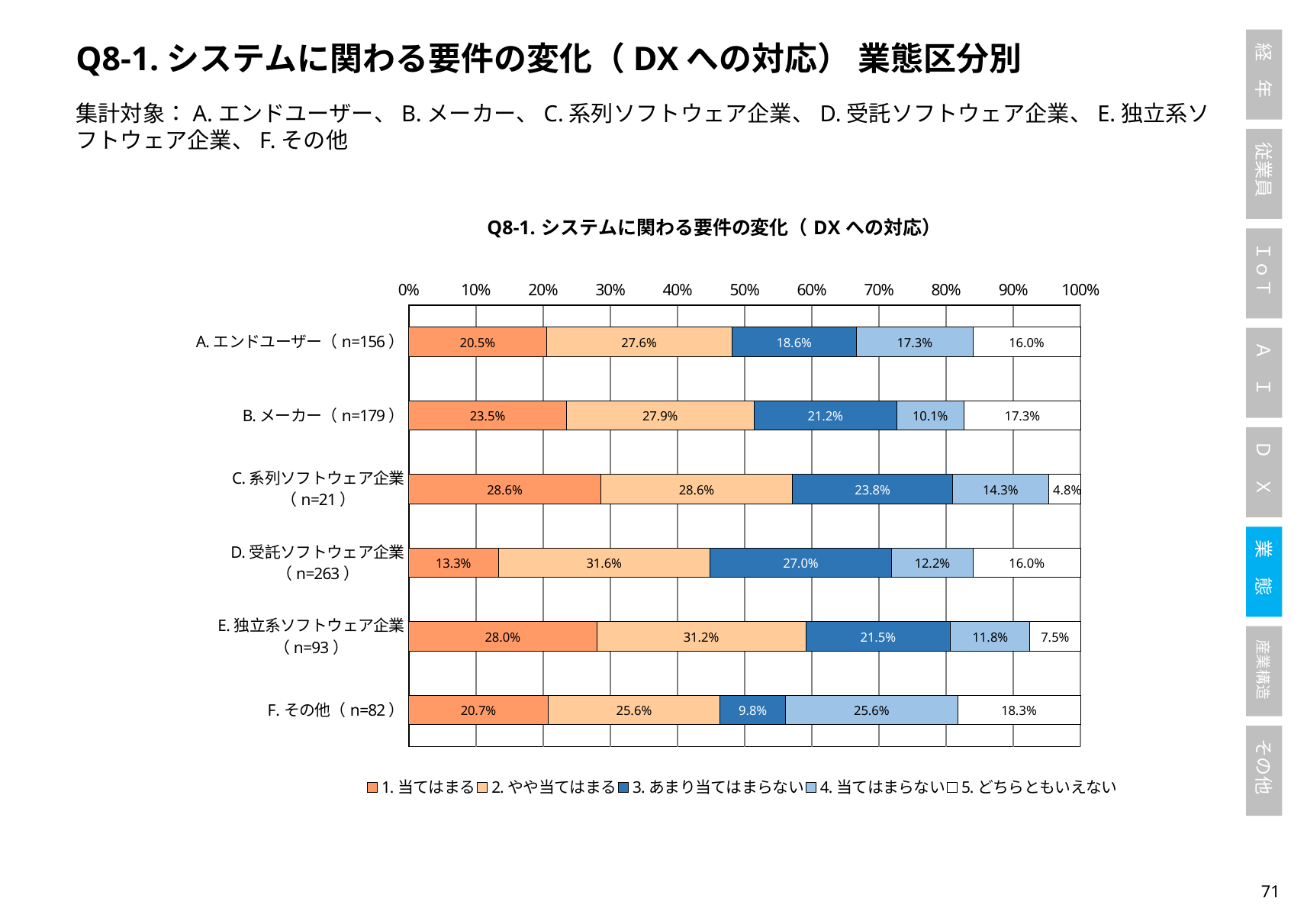
What is the value of "5. どちらともいえない" for "C. 系列ソフトウェア企業 (n=21)"? 4.8% What is the title of the chart? Q8-1. システムに関わる要件の変化（DXへの対応） What is the value of "2. やや当てはまる" for "D. 受託ソフトウェア企業 (n=263)"? 31.6% What is the value of "1. 当てはまる" for "B. メーカー (n=179)"? 23.5% What is the value of "3. あまり当てはまらない" for "F. その他 (n=82)"? 9.8% Which category has the lowest value for "1. 当てはまる"? D. 受託ソフトウェア企業 (n=263) Which category has the highest value for "1. 当てはまる"? C. 系列ソフトウェア企業 (n=21) What is the difference between the "4. 当てはまらない" values for "F. その他 (n=82)" and "B. メーカー (n=179)"? 15.5% Which is larger: the "3. あまり当てはまらない" value for "D. 受託ソフトウェア企業 (n=263)" or for "A. エンドユーザー (n=156)"? D. 受託ソフトウェア企業 (n=263) How many categories (業態区分) are plotted on the chart? 6 How many series does the legend list? 5 What type of chart is shown on the slide? Stacked bar chart